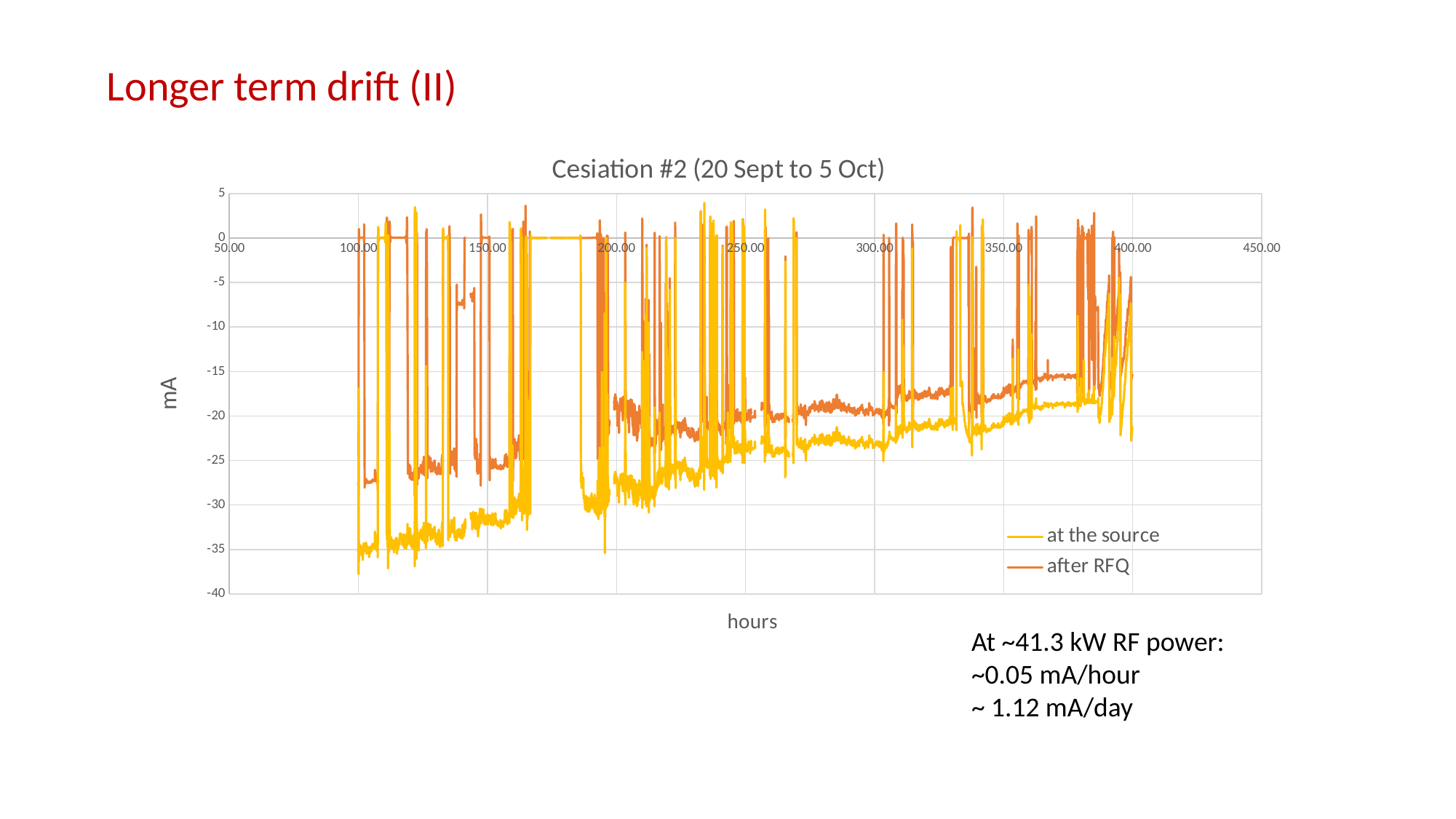
Is the baseline value for 'at the source' near 100 hours greater or less than -30? less Is the baseline value for 'after RFQ' near 100 hours greater or less than -30? greater How many series does the legend list? 2 What is the title of the chart? Cesiation #2 (20 Sept to 5 Oct) Is the baseline value for 'after RFQ' near 390 hours greater or less than -20? greater Do the baseline values of the 'after RFQ' series rise or fall as hours increase from 100 to 400? rise Do the baseline values of the 'at the source' series rise or fall as hours increase from 100 to 400? rise Which series has the lower (more negative) values throughout the chart, 'at the source' or 'after RFQ'? at the source What colour is the 'after RFQ' line in the chart? orange What kind of chart is shown on the slide? line chart